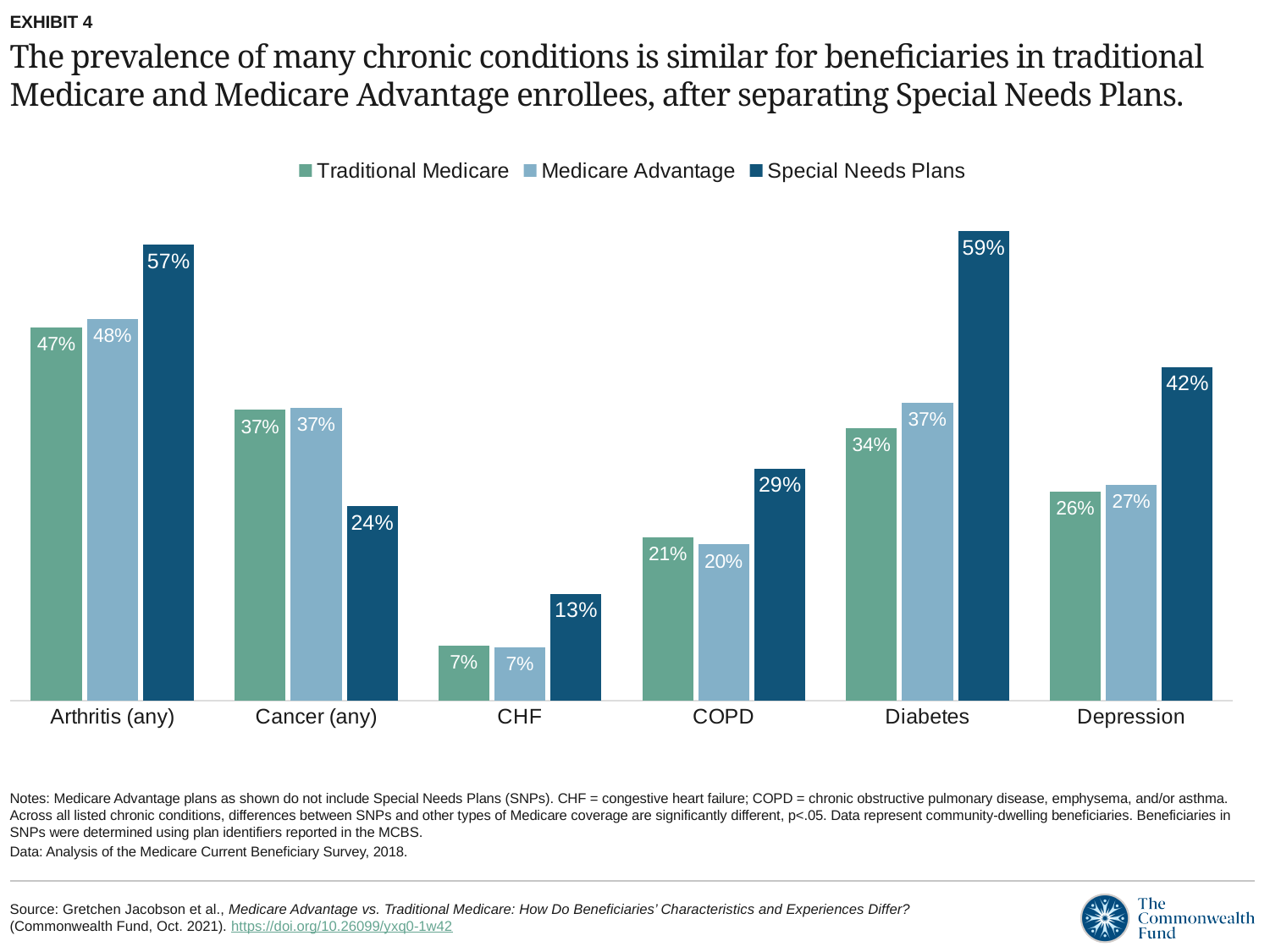
Which series is shown in the darkest blue colour in the legend? Special Needs Plans What is the value for Special Needs Plans for Diabetes? 59% What is the difference between the Special Needs Plans value and the Medicare Advantage value for Diabetes? 22% Which condition has the lowest value for Traditional Medicare? CHF How many chronic conditions are shown on the x axis? 6 Which condition has the highest value for Special Needs Plans? Diabetes What kind of chart is shown on the slide? Bar chart What is the value for Medicare Advantage for COPD? 20% What is the value for Traditional Medicare for Arthritis (any)? 47% How many series does the legend list? 3 What is the difference between the Special Needs Plans value and the Traditional Medicare value for Depression? 16% Which is larger for Cancer (any): the Medicare Advantage value or the Special Needs Plans value? Medicare Advantage